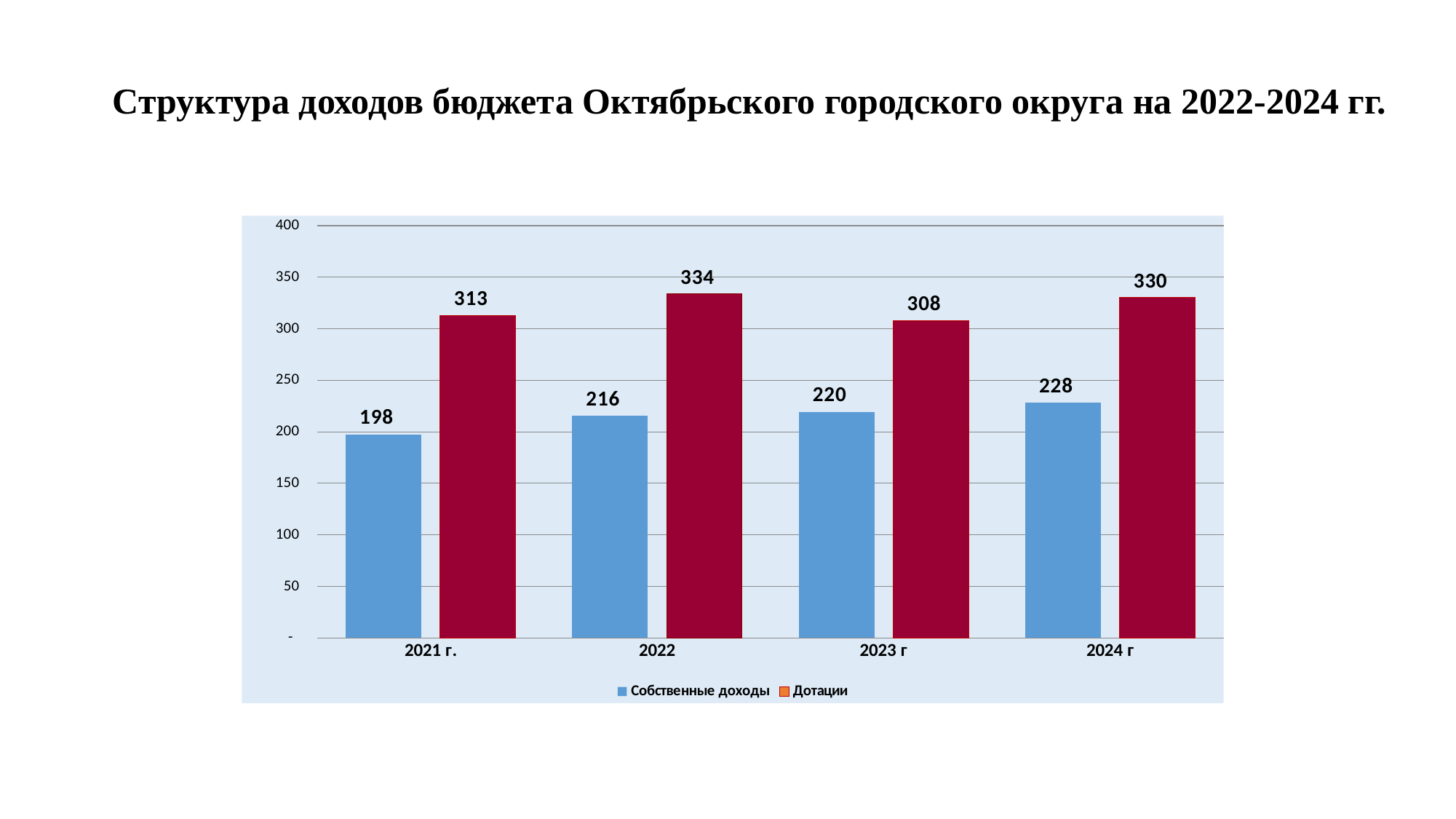
What is the value of Собственные доходы for 2024 г? 228 What is the value of Дотации for 2022? 334 In which year is Собственные доходы lowest? 2021 г. Which is larger in 2024 г: Собственные доходы or Дотации? Дотации What is the difference between Дотации and Собственные доходы in 2021 г.? 115 How many years are shown on the x axis? 4 What is the value of Дотации for 2023 г? 308 What is the value of Собственные доходы for 2021 г.? 198 In which year is Дотации highest? 2022 What kind of chart is shown on the slide? Bar chart How many series does the legend list? 2 Do the values for Собственные доходы rise or fall from 2021 г. to 2024 г? Rise